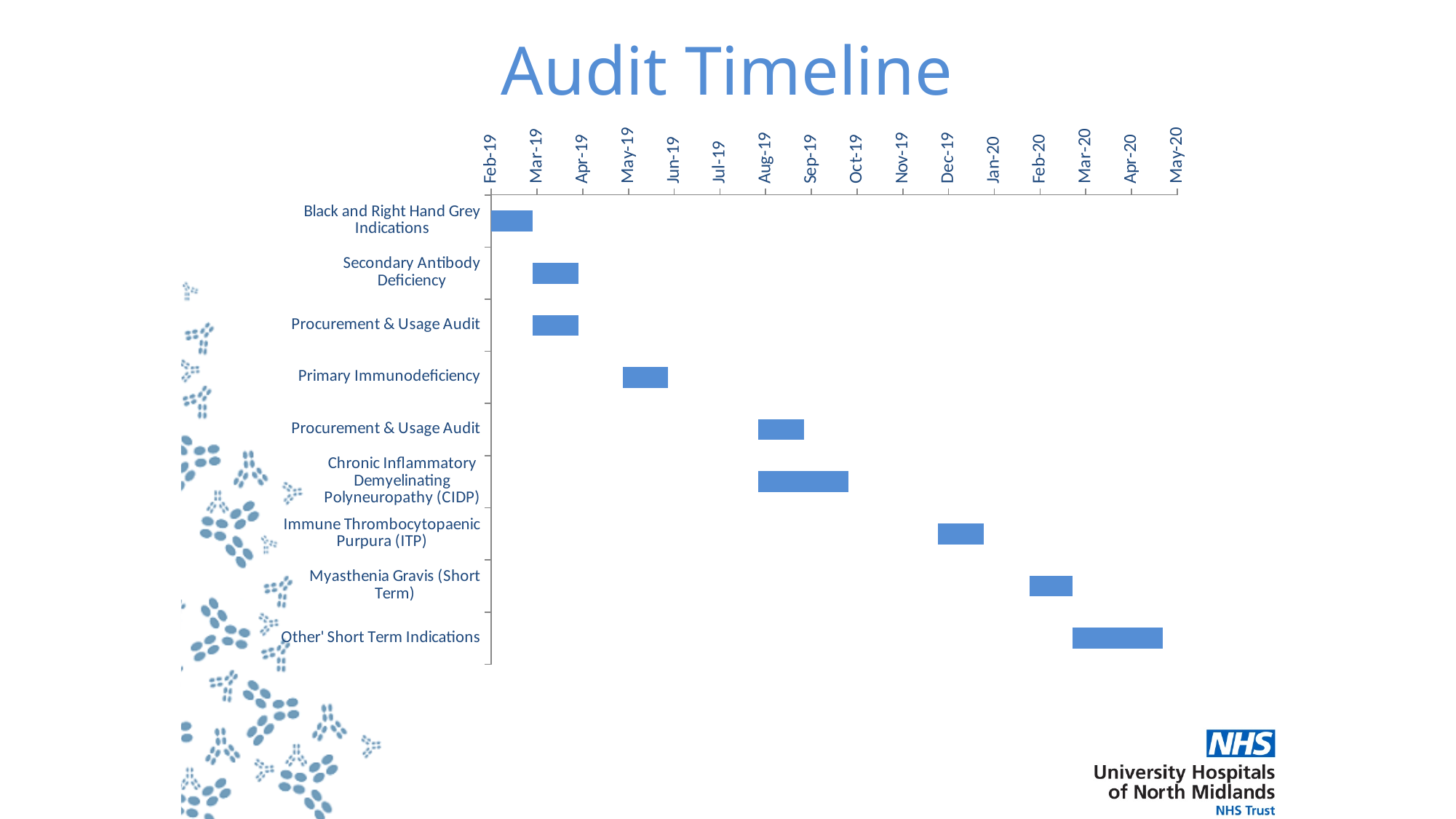
Which audit category has the latest start on the timeline? Other' Short Term Indications Which bar is longer, Chronic Inflammatory Demyelinating Polyneuropathy (CIDP) or Immune Thrombocytopaenic Purpura (ITP)? Chronic Inflammatory Demyelinating Polyneuropathy (CIDP) What are the first and last months shown on the horizontal axis? Feb-19 and May-20 In which month does the bar for Myasthenia Gravis (Short Term) begin? Feb-20 Which audit category has the earliest start on the timeline? Black and Right Hand Grey Indications How many audit categories are listed on the vertical axis of the chart? 9 In which month does the bar for Chronic Inflammatory Demyelinating Polyneuropathy (CIDP) begin? Aug-19 Which starts later on the timeline, Immune Thrombocytopaenic Purpura (ITP) or Primary Immunodeficiency? Immune Thrombocytopaenic Purpura (ITP) What kind of chart is shown on the slide? bar chart What is the title of the chart? Audit Timeline In which month does the bar for Immune Thrombocytopaenic Purpura (ITP) begin? Dec-19 In which month does the bar for Primary Immunodeficiency begin? May-19